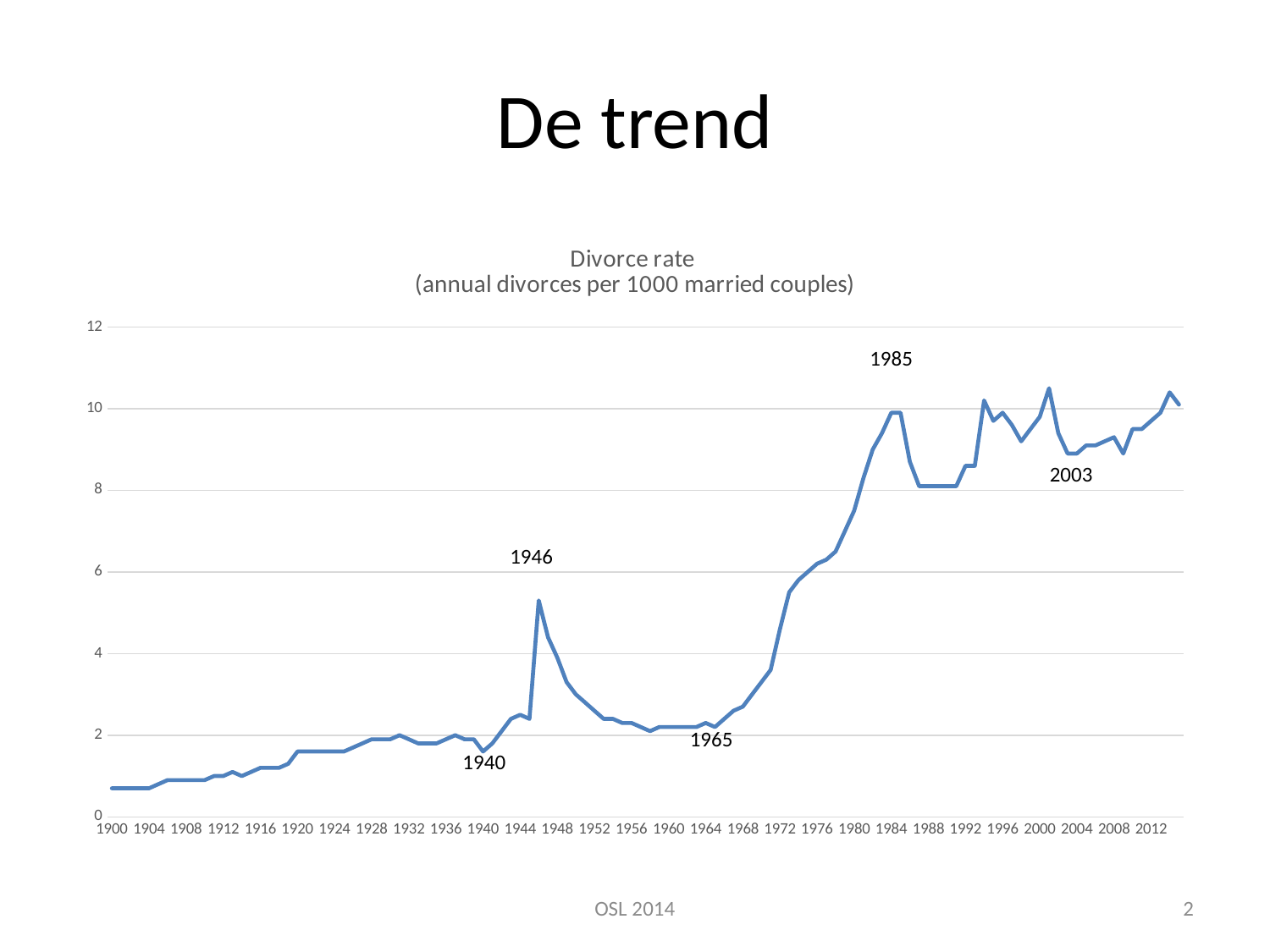
Between the annotated years 1946 and 1965, does the divorce rate rise or fall? fall Is the divorce rate in 1946 greater or less than 4? greater Which of the annotated years, 1946 or 1985, has the higher divorce rate? 1985 Is the divorce rate in 1900 greater or less than 2? less Is the divorce rate in 1985 greater or less than 8? greater Overall, does the divorce rate rise or fall from 1900 to 2012? rise What is the title of the chart? Divorce rate (annual divorces per 1000 married couples) What is the highest value shown on the vertical axis? 12 Of the five annotated years (1940, 1946, 1965, 1985, 2003), which has the lowest divorce rate? 1940 What kind of chart is shown on the slide? line chart